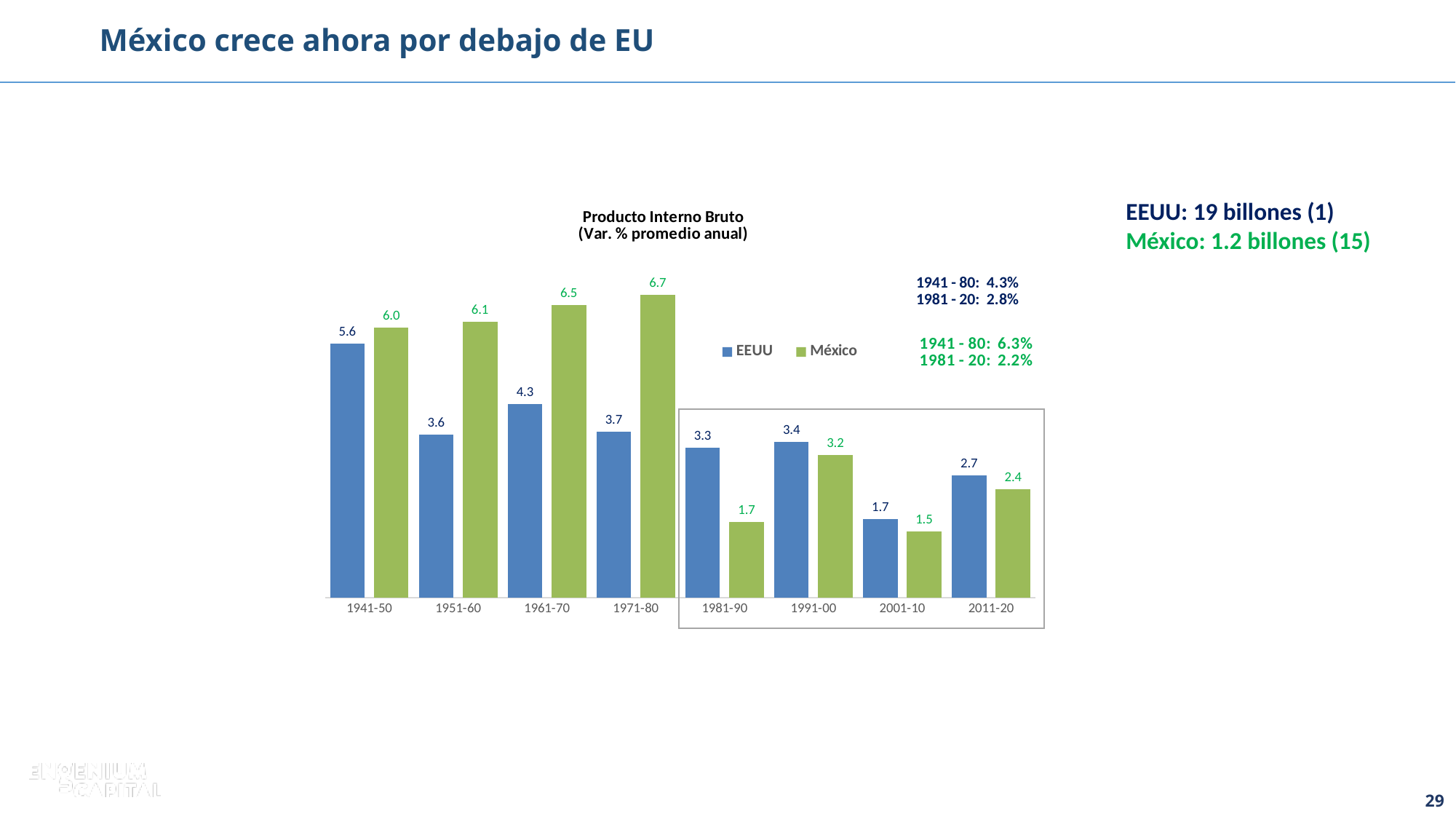
How many periods are shown on the x axis? 8 What is the title of the chart? Producto Interno Bruto (Var. % promedio anual) What is the difference between the México and EEUU values in 1981-90? 1.6 How many series does the legend list? 2 What is the value for México in 1971-80? 6.7 What is the value for México in 2001-10? 1.5 Which is larger in 2011-20, EEUU or México? EEUU In which period is the EEUU value highest? 1941-50 Which is larger in 1961-70, EEUU or México? México What is the value for EEUU in 1991-00? 3.4 In which period is the México value lowest? 2001-10 What kind of chart is shown? Bar chart